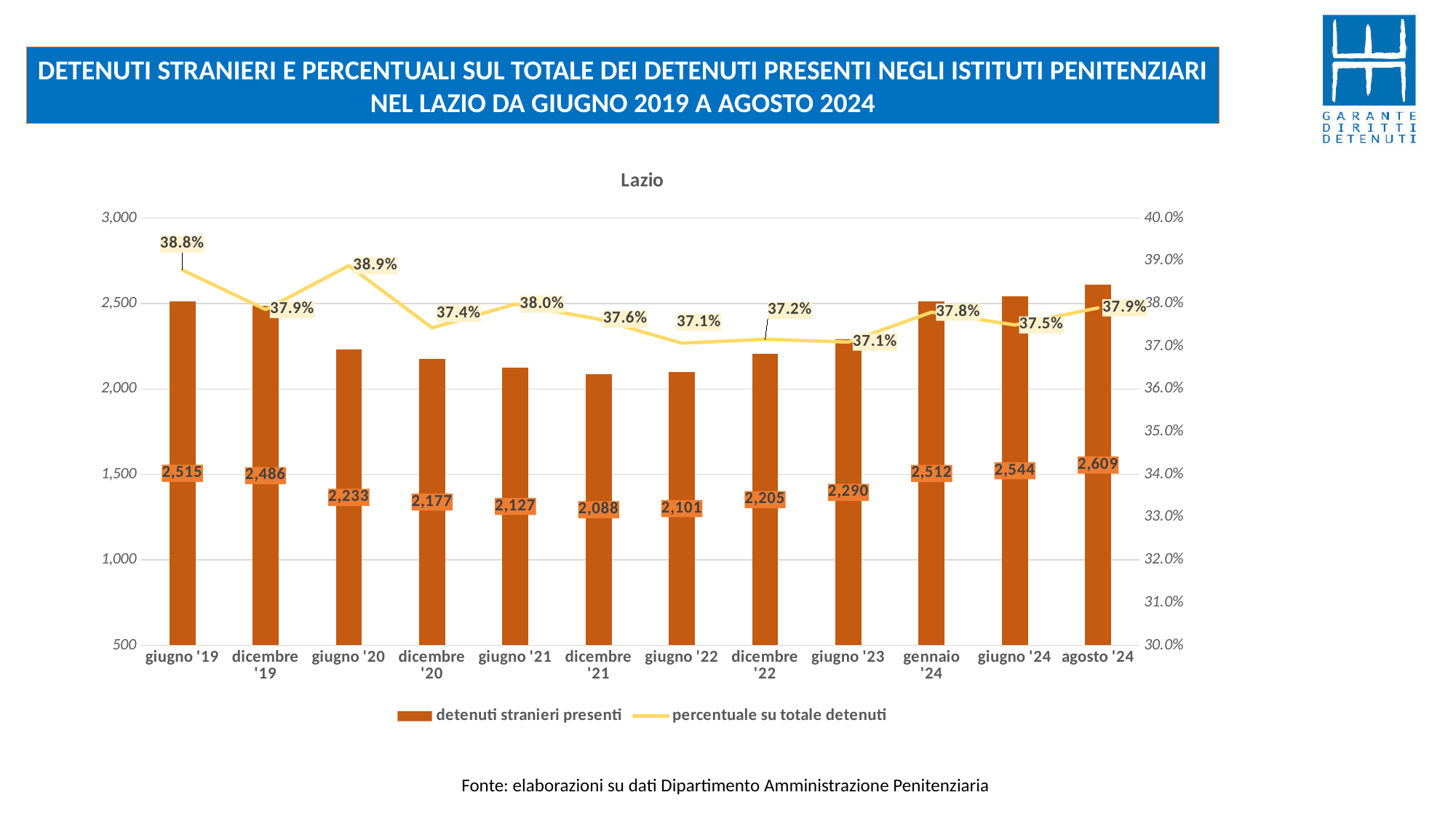
How many series does the legend list? 2 What kind of chart is shown on the slide? Combined bar and line chart What is the percentage on total detainees (percentuale su totale detenuti) for giugno '20? 38.9% How many time periods are shown on the x axis? 12 What is the title shown above the chart plot area? Lazio What is the value of detenuti stranieri presenti for agosto '24? 2,609 Which period has the highest number of detenuti stranieri presenti? agosto '24 How many foreign detainees (detenuti stranieri presenti) are shown for giugno '19? 2,515 Which period has the highest percentuale su totale detenuti? giugno '20 Which is larger, the number of detenuti stranieri presenti in giugno '22 or in dicembre '22? dicembre '22 What is the difference in detenuti stranieri presenti between agosto '24 and dicembre '21? 521 Which period has the lowest number of detenuti stranieri presenti? dicembre '21